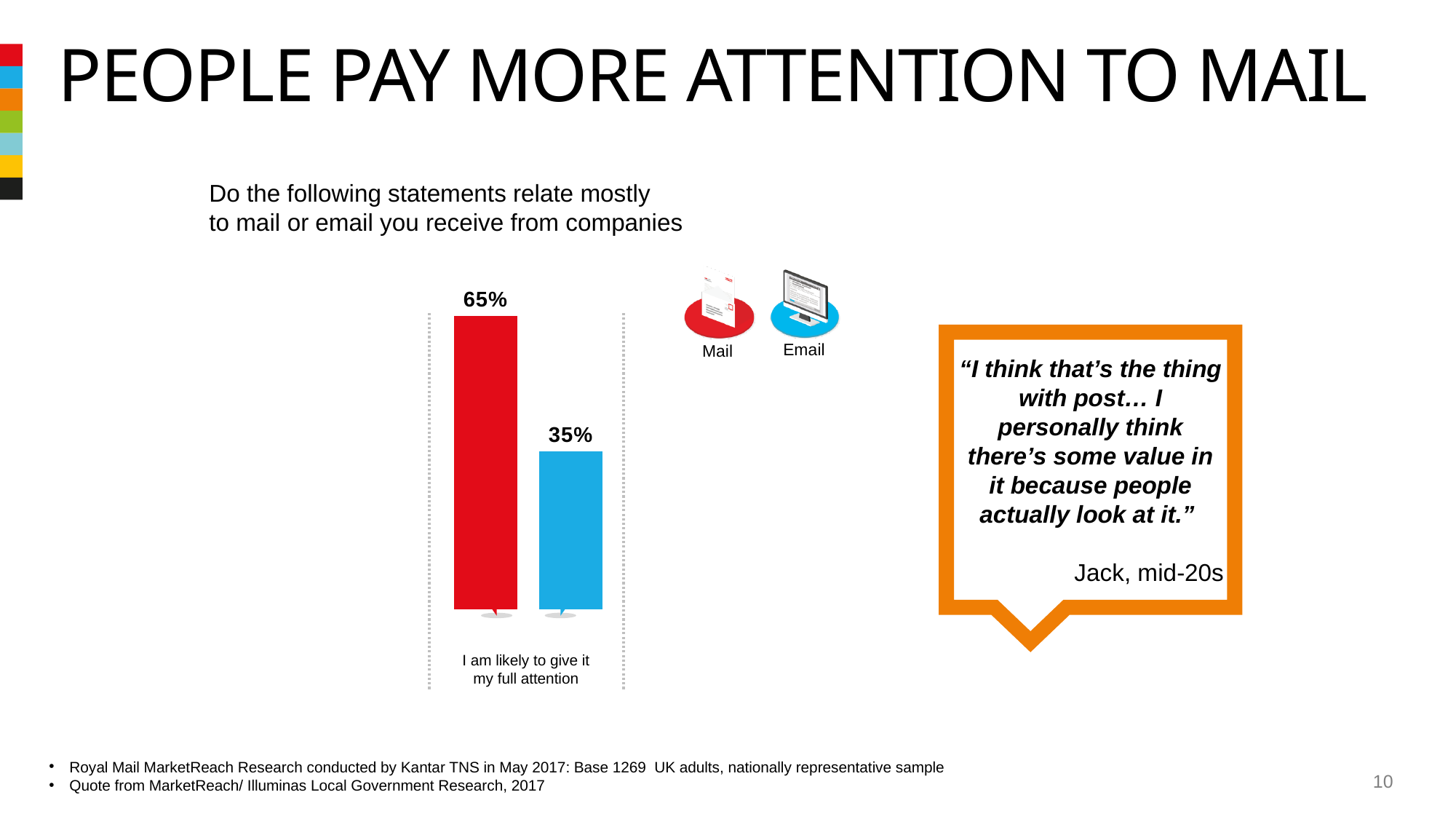
What kind of chart is shown on the slide? Bar chart What percentage is shown for Email for the statement "I am likely to give it my full attention"? 35% What is the total of the Mail and Email values shown in the chart? 100% Which channel has the lowest value in the chart? Email How many series (channels) does the chart's legend show? 2 What statement is the chart's category labelled with? I am likely to give it my full attention What colour is the bar representing Mail? Red Which channel has the higher value for "I am likely to give it my full attention", Mail or Email? Mail How many bars are plotted in the chart? 2 What is the difference between the Mail and Email values for "I am likely to give it my full attention"? 30% What percentage is shown for Mail for the statement "I am likely to give it my full attention"? 65%